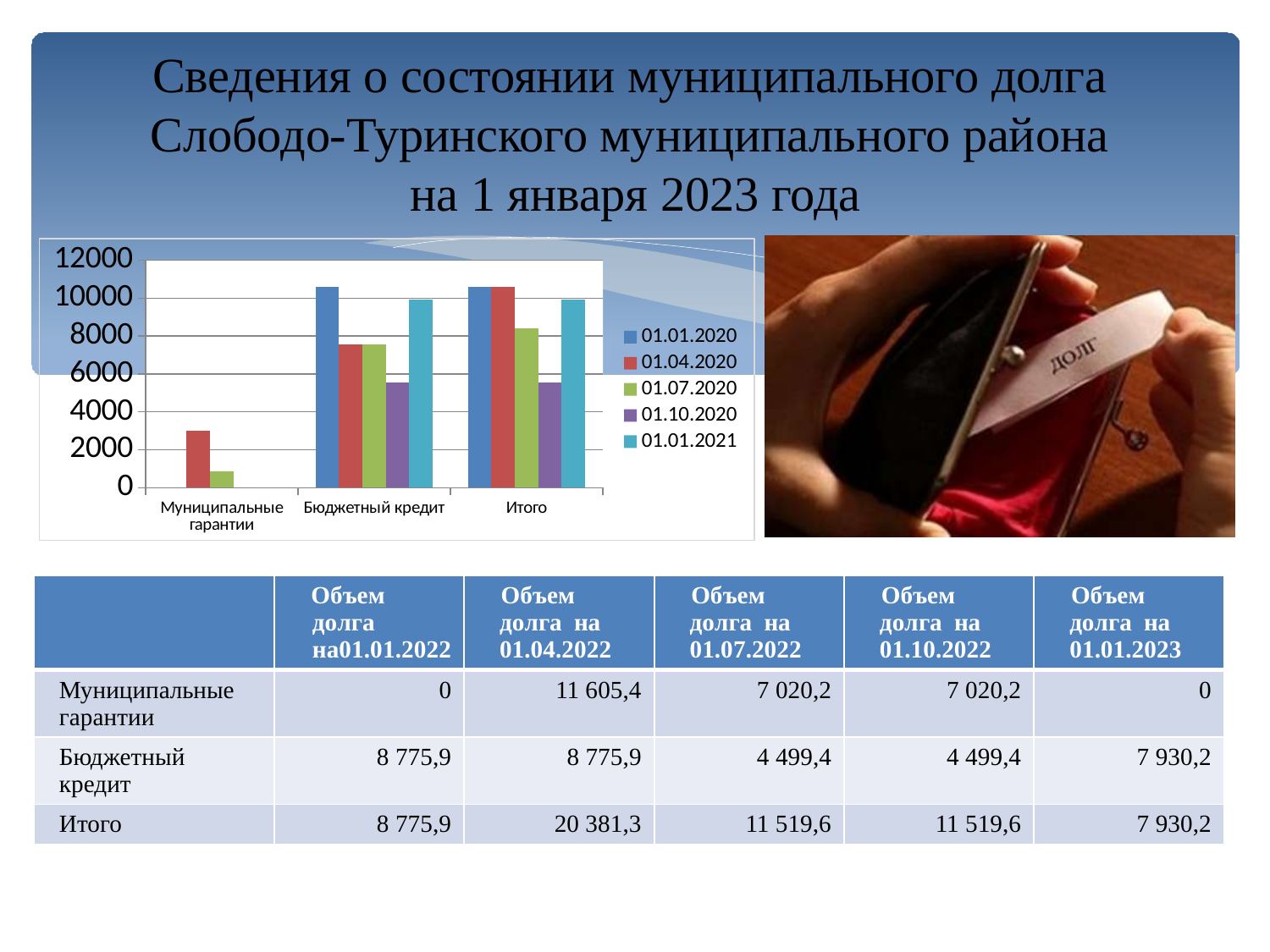
For the category Бюджетный кредит, which series has the lowest bar? 01.10.2020 How many series does the chart legend list? 5 What kind of chart is shown on the slide? bar chart Is the value for Бюджетный кредит in the 01.01.2021 series greater or less than 8000? greater For the category Муниципальные гарантии, which series has the highest bar? 01.04.2020 Is the value for Итого in the 01.10.2020 series greater or less than 8000? less Which series is listed last in the chart legend? 01.01.2021 Which series is listed first in the chart legend? 01.01.2020 For the category Итого, which is larger: the 01.01.2020 value or the 01.07.2020 value? 01.01.2020 How many categories are shown on the x axis of the chart? 3 Is the value for Бюджетный кредит in the 01.01.2020 series greater or less than 8000? greater